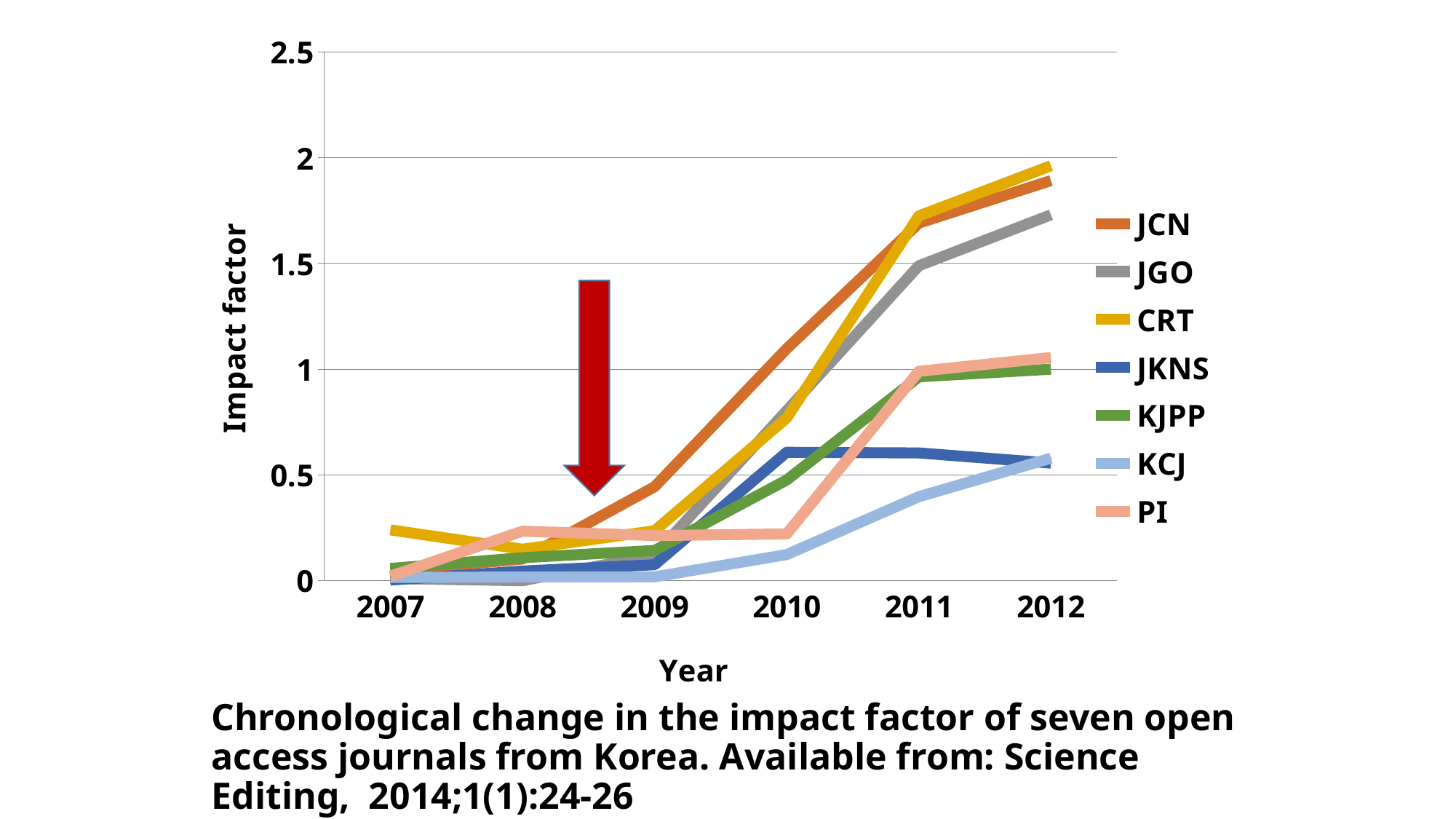
Does the impact factor for JCN rise or fall from 2007 to 2012? rise Which journal has the highest impact factor in 2010? JCN Is the impact factor for KCJ in 2011 greater or less than 0.5? less What is the label of the y axis? Impact factor Is the impact factor for JCN in 2012 greater or less than 1.5? greater In 2012, which has the larger impact factor, CRT or KCJ? CRT Is the impact factor for JKNS in 2010 greater or less than 0.5? greater How many years are shown on the x axis? 6 How many series does the legend list? 7 What kind of chart is shown on the slide? line chart Which journal has the lowest impact factor in 2011? KCJ